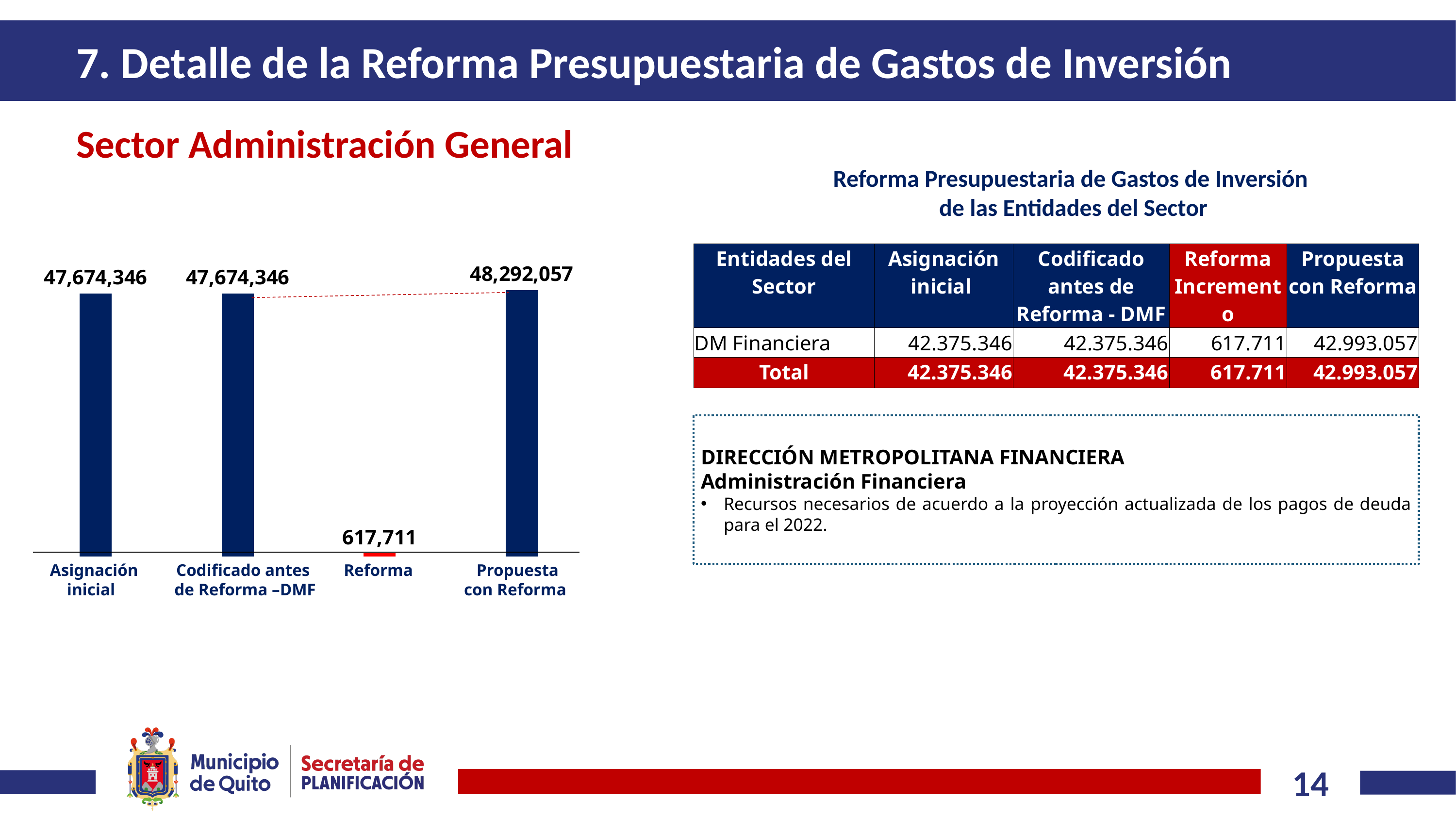
How many categories are shown in the bar chart? 4 What is the value for Asignación inicial in the bar chart? 47,674,346 What kind of chart is shown on the left of the slide? Bar chart What is the value for Codificado antes de Reforma –DMF in the bar chart? 47,674,346 What is the value for Reforma in the bar chart? 617,711 Which is larger in the bar chart, Propuesta con Reforma or Asignación inicial? Propuesta con Reforma Which category has the lowest value in the bar chart? Reforma Which category has the highest value in the bar chart? Propuesta con Reforma What is the difference between Propuesta con Reforma and Codificado antes de Reforma –DMF in the bar chart? 617,711 What is the value for Propuesta con Reforma in the bar chart? 48,292,057 Do the values for Asignación inicial and Codificado antes de Reforma –DMF differ in the bar chart? No, both are 47,674,346 Which bar in the chart is coloured red rather than dark blue? Reforma